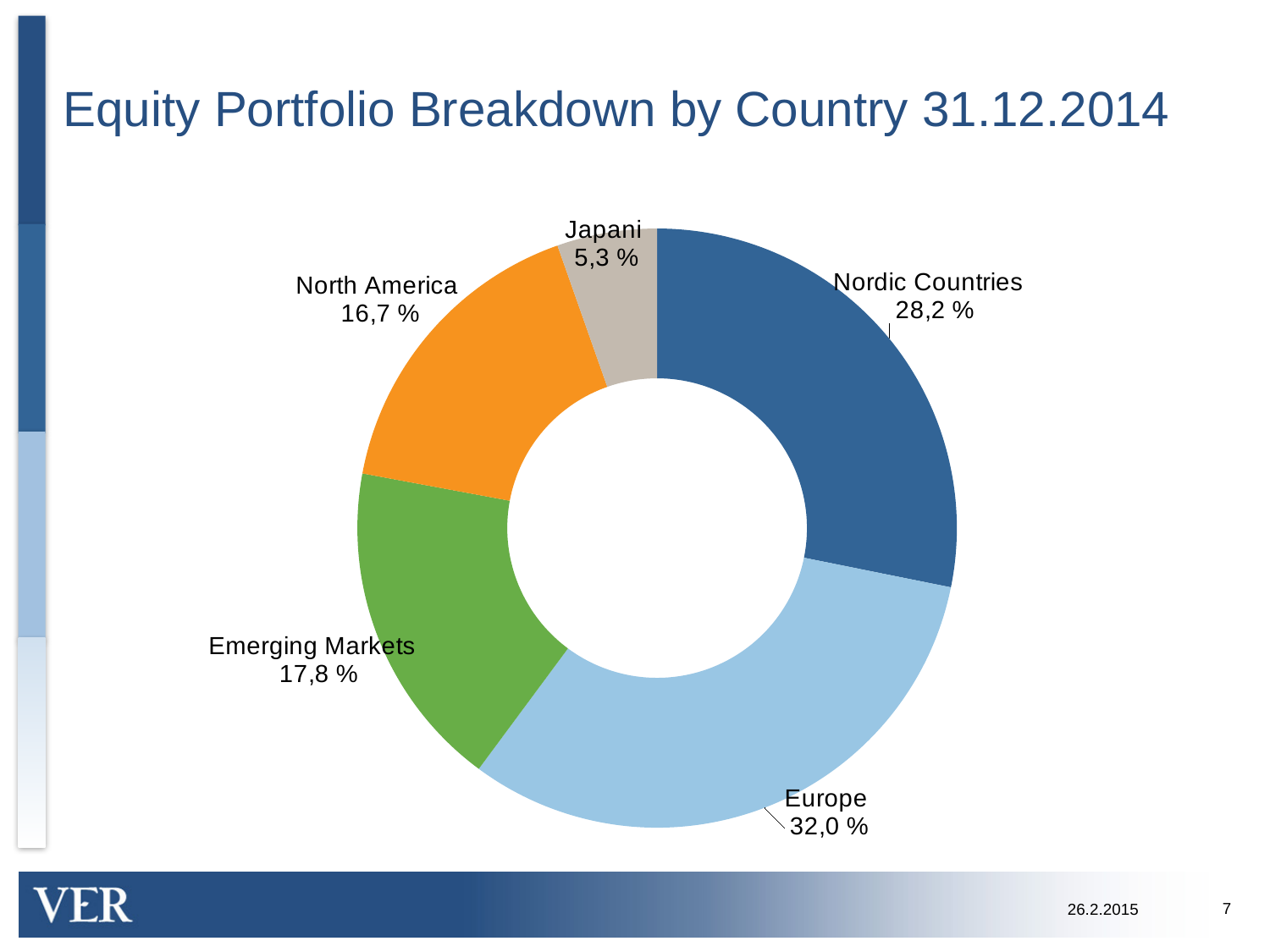
Which has a larger share, Emerging Markets or North America? Emerging Markets What is the difference in percentage points between the Europe share and the Nordic Countries share? 3,8 How many regions are shown in the chart? 5 What is the title of the chart on the slide? Equity Portfolio Breakdown by Country 31.12.2014 What share of the equity portfolio is in Europe? 32,0 % What share of the equity portfolio is in Nordic Countries? 28,2 % What share of the equity portfolio is in Japani? 5,3 % Which region has the smallest share of the equity portfolio? Japani Which region has the largest share of the equity portfolio? Europe What share of the equity portfolio is in North America? 16,7 % What share of the equity portfolio is in Emerging Markets? 17,8 % What kind of chart is shown on the slide? Doughnut (pie) chart